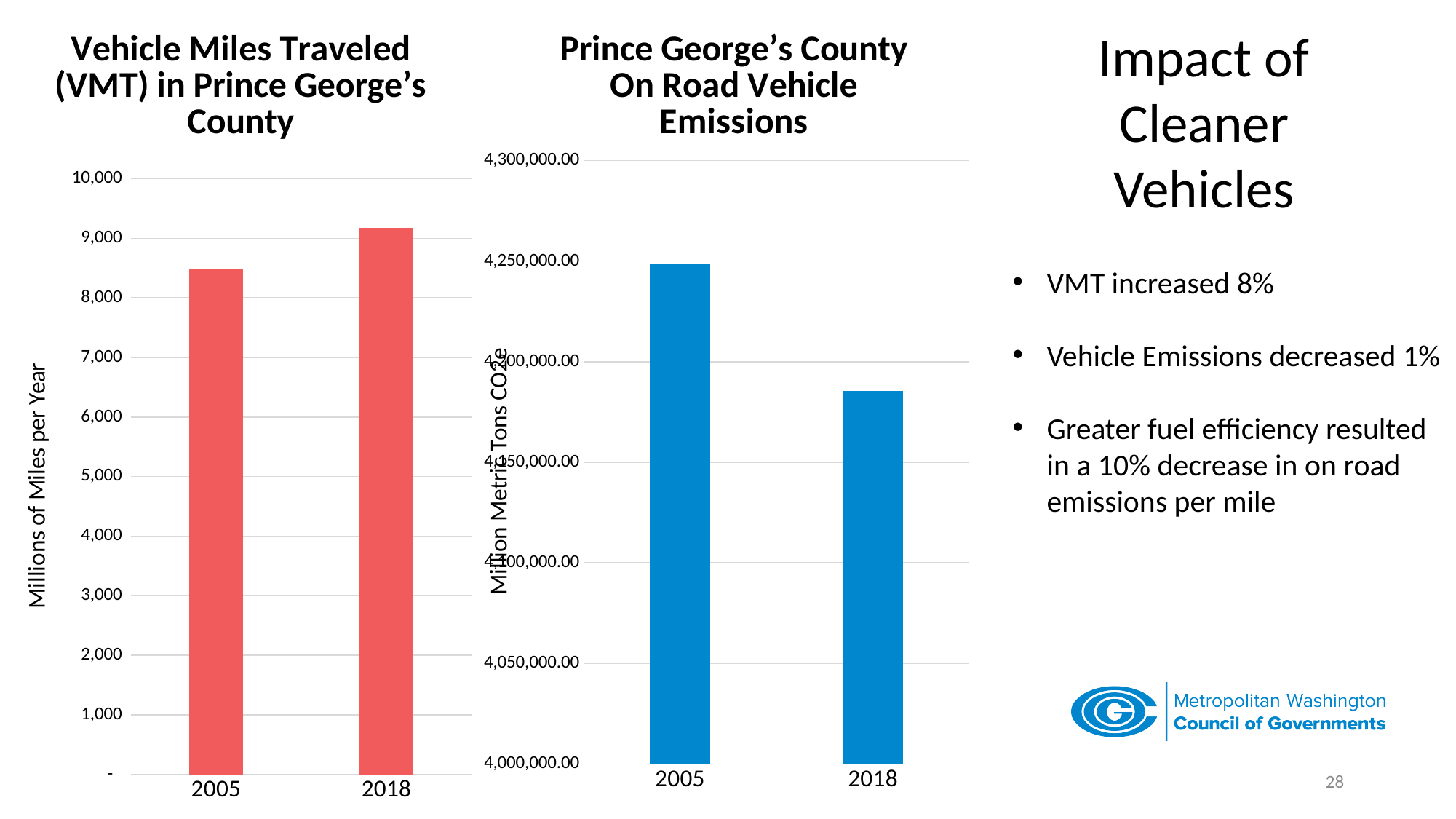
In the 'Vehicle Miles Traveled (VMT) in Prince George's County' chart, is the value for 2005 greater or less than 8,000? greater In the 'Vehicle Miles Traveled (VMT) in Prince George's County' chart, do the values rise or fall from 2005 to 2018? rise In the 'Vehicle Miles Traveled (VMT) in Prince George's County' chart, what kind of chart is shown? bar chart In the 'Prince George's County On Road Vehicle Emissions' chart, do the values rise or fall from 2005 to 2018? fall In the 'Vehicle Miles Traveled (VMT) in Prince George's County' chart, how many years are plotted? 2 In the 'Prince George's County On Road Vehicle Emissions' chart, which year has the lower value? 2018 In the 'Vehicle Miles Traveled (VMT) in Prince George's County' chart, what is the label on the vertical axis? Millions of Miles per Year In the 'Vehicle Miles Traveled (VMT) in Prince George's County' chart, is the value for 2018 greater or less than 9,000? greater In the 'Prince George's County On Road Vehicle Emissions' chart, is the value for 2018 greater or less than 4,200,000.00? less In the 'Vehicle Miles Traveled (VMT) in Prince George's County' chart, which year has the higher value? 2018 In the 'Prince George's County On Road Vehicle Emissions' chart, what colour are the bars? blue